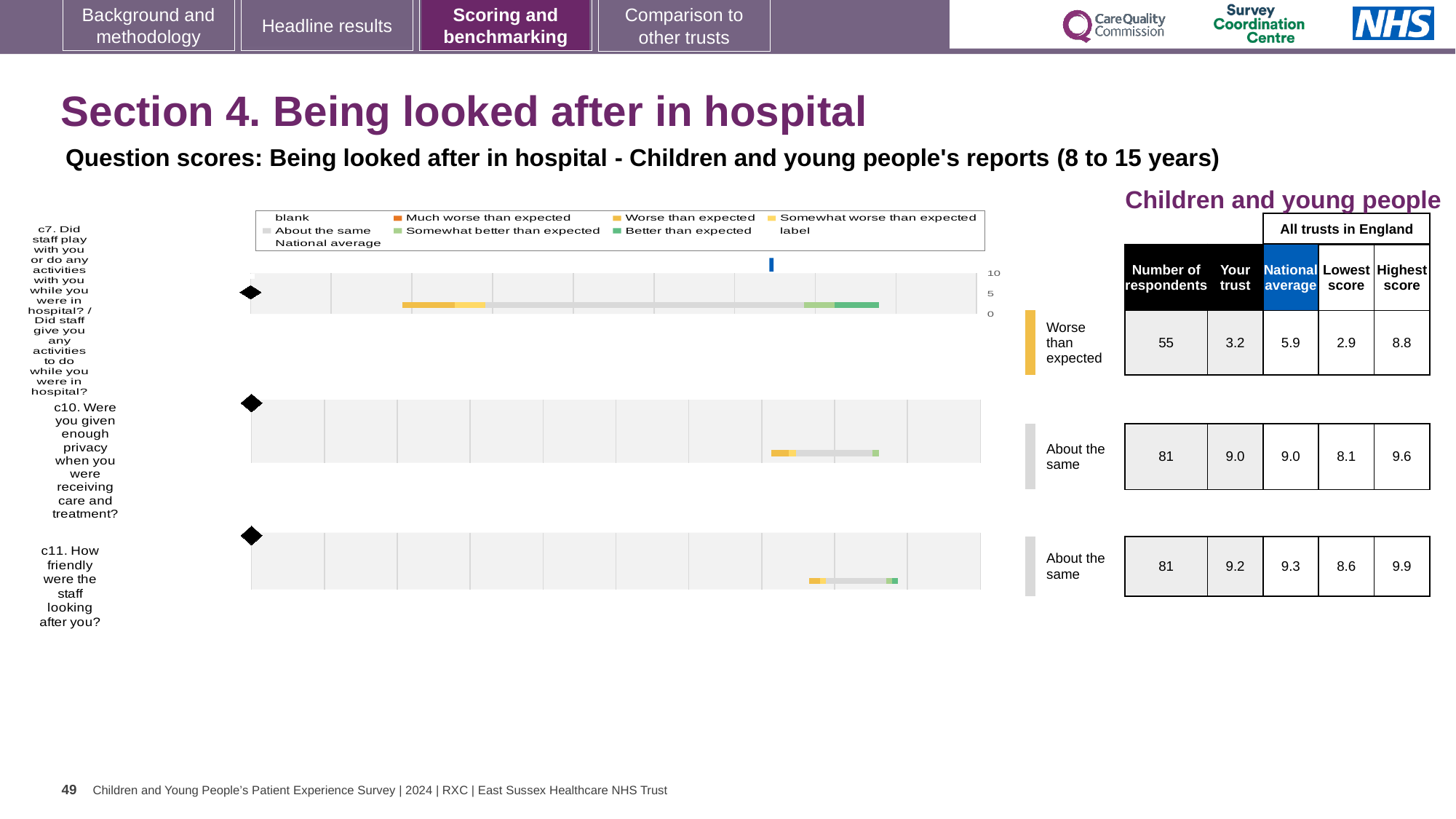
What kind of chart is used to show the question scores on this slide? Bar chart How many respondents answered question c11 (How friendly were the staff looking after you?)? 81 What is the national average score for question c10 (Were you given enough privacy when you were receiving care and treatment?)? 9.0 Is the 'Your trust' score for question c7 greater or less than 5? less What is the difference between the national average and the 'Your trust' score for question c7? 2.7 Which has the larger 'Your trust' score, question c10 or question c11? c11 Which benchmark category is shown for question c7? Worse than expected What is the highest score among all trusts in England for question c7? 8.8 How many questions are plotted on this slide? 3 Which question has the lowest 'Your trust' score on this slide? c7. Did staff play with you or do any activities with you while you were in hospital? What is the 'Your trust' score for question c7 (Did staff play with you or do any activities with you while you were in hospital?)? 3.2 Which question has the highest 'Your trust' score on this slide? c11. How friendly were the staff looking after you?